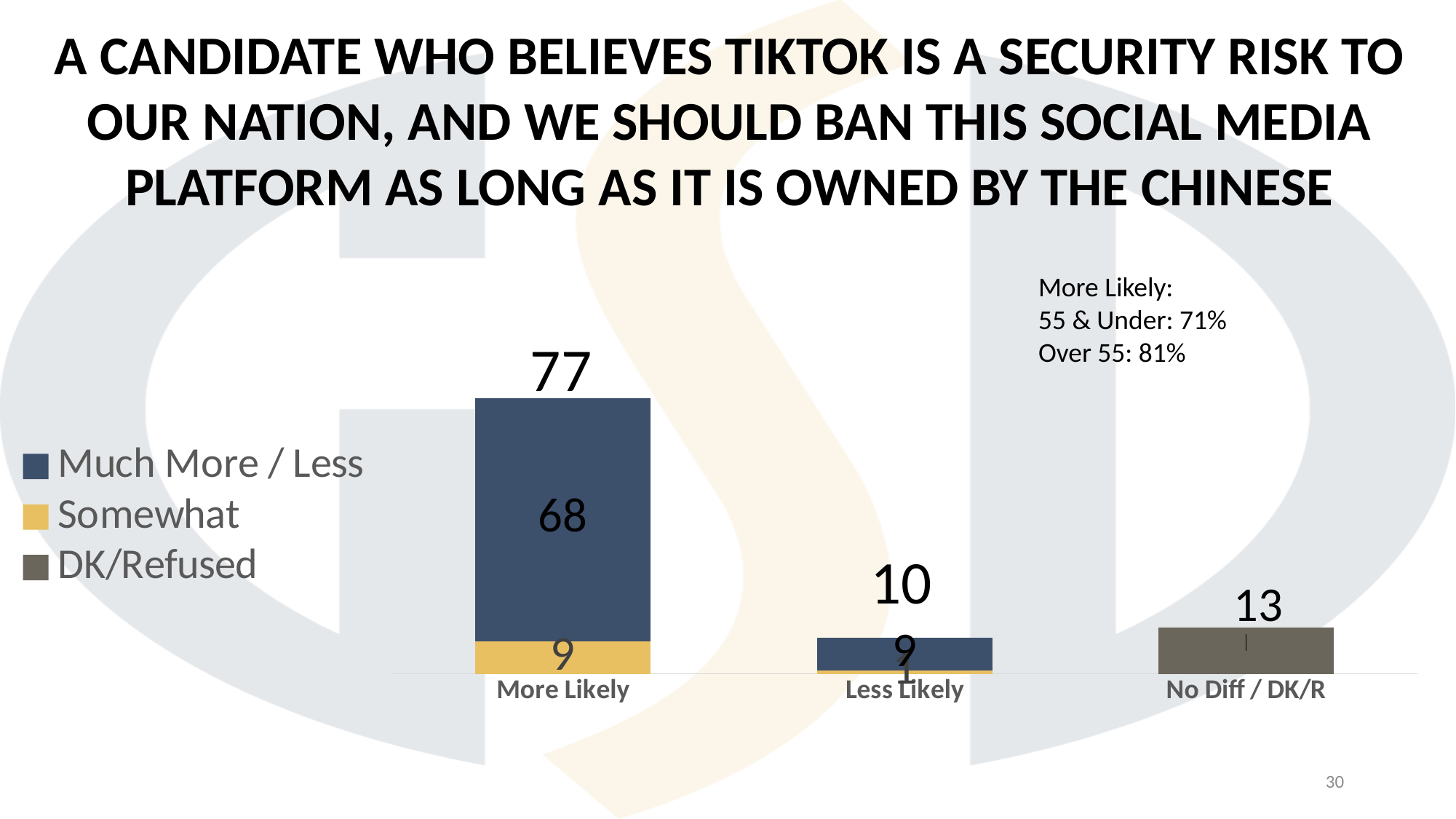
What is the Much More / Less value for the Less Likely category? 9 Which category has the lowest total? Less Likely What is the total value shown above the More Likely bar? 77 Which is larger, the No Diff / DK/R value or the Less Likely total? No Diff / DK/R What is the difference between the More Likely total and the Less Likely total? 67 How many series does the legend list? 3 What is the Somewhat value for the More Likely category? 9 What is the total value shown above the Less Likely bar? 10 How many categories are shown on the x axis? 3 What is the Much More / Less value for the More Likely category? 68 What is the value for the No Diff / DK/R category? 13 Which category has the highest total? More Likely